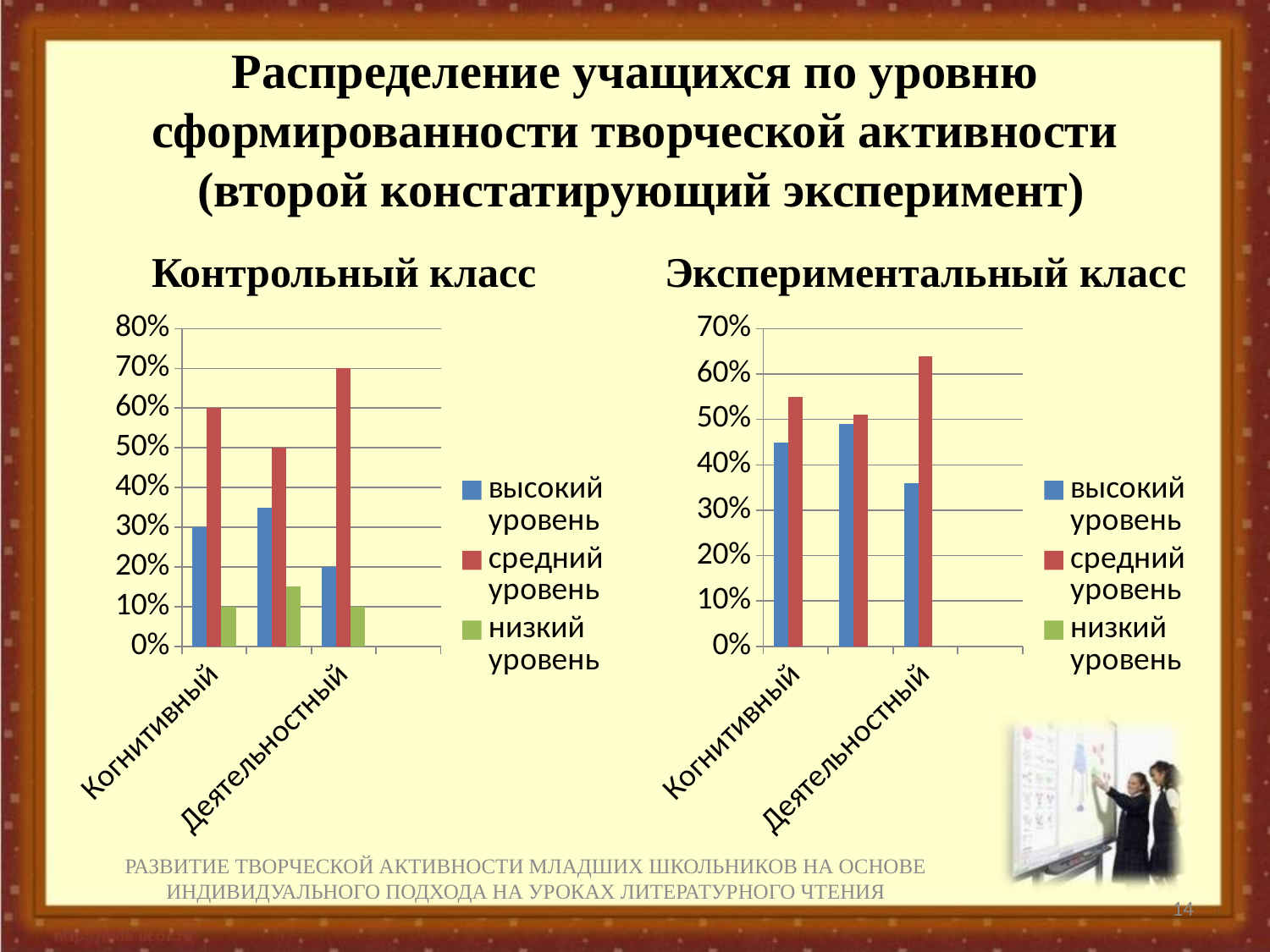
In the "Контрольный класс" chart, what is the value of низкий уровень for Когнитивный? 10% In the "Контрольный класс" chart, which level has the highest value for Когнитивный? средний уровень In the "Контрольный класс" chart, what is the difference between средний уровень and низкий уровень for Когнитивный? 50% In the "Экспериментальный класс" chart, is the value of высокий уровень for Когнитивный greater or less than 40%? greater In the "Контрольный класс" chart, what is the value of средний уровень for Когнитивный? 60% In the "Контрольный класс" chart, which is larger for Деятельностный: высокий уровень or низкий уровень? высокий уровень In the "Экспериментальный класс" chart, is the value of средний уровень for Деятельностный greater or less than 60%? greater In the "Контрольный класс" chart, is the value of высокий уровень for Деятельностный greater or less than 30%? less How many series does the legend of the "Экспериментальный класс" chart list? 3 What kind of chart is the "Контрольный класс" chart? bar chart In the "Контрольный класс" chart, what is the value of средний уровень for Деятельностный? 70% In the "Экспериментальный класс" chart, which is larger for Когнитивный: высокий уровень or средний уровень? средний уровень